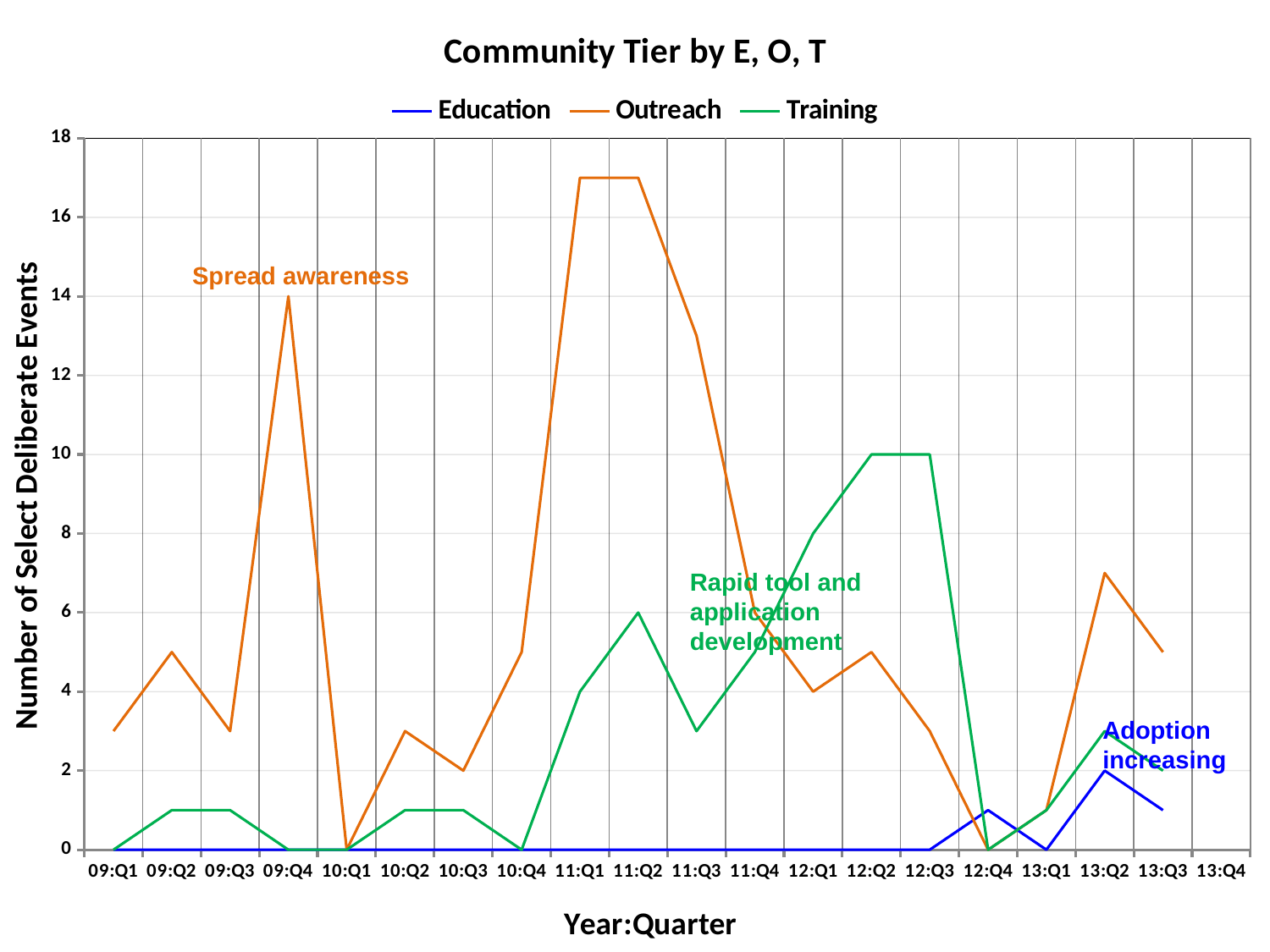
What kind of chart is shown on the slide? line chart What is the value for Outreach at 09:Q4? 14 How many series does the legend list? 3 Does the Training line rise or fall from 12:Q3 to 12:Q4? fall Is the value for Outreach at 11:Q1 greater or less than 16? greater What is the difference between Training at 12:Q2 and Training at 11:Q2? 4 Is the value for Outreach at 13:Q2 greater or less than 8? less At 12:Q2, which is larger, Training or Outreach? Training What is the value for Training at 12:Q2? 10 Which series reaches the highest value on the chart? Outreach What is the value for Education at 13:Q2? 2 What is the title of the y axis? Number of Select Deliberate Events